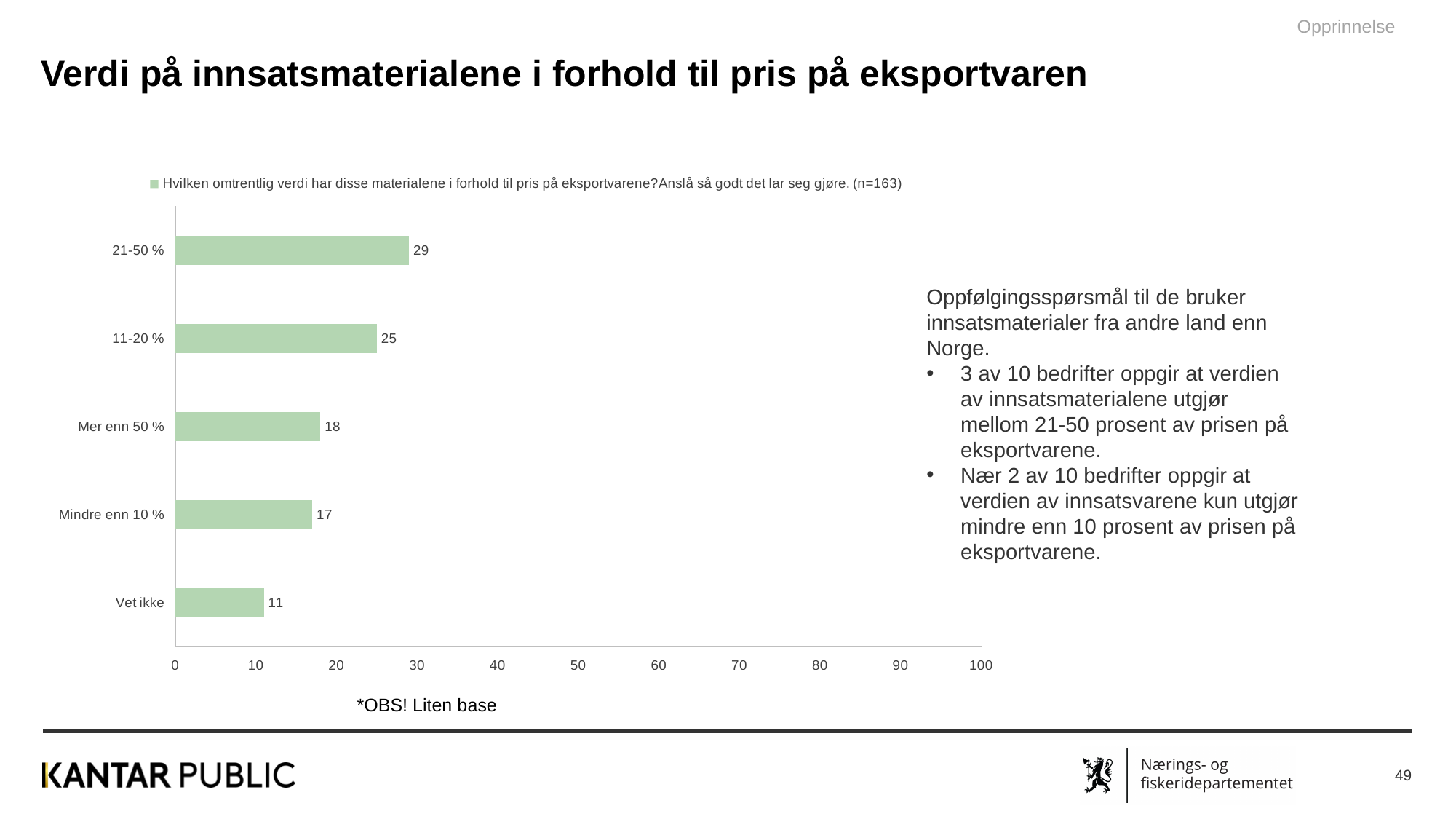
What kind of chart is shown on the slide? Bar chart How many series does the legend list? 1 Which category has the lowest value? Vet ikke What is the value for the category "21-50 %"? 29 Which category has the highest value? 21-50 % What is the value for the category "Vet ikke"? 11 Is the value for "11-20 %" greater or less than 20? greater What is the maximum value shown on the horizontal axis? 100 What is the difference between the values for "21-50 %" and "11-20 %"? 4 How many categories are shown in the chart? 5 What is the value for the category "Mindre enn 10 %"? 17 Which has a larger value, "Mer enn 50 %" or "Mindre enn 10 %"? Mer enn 50 %